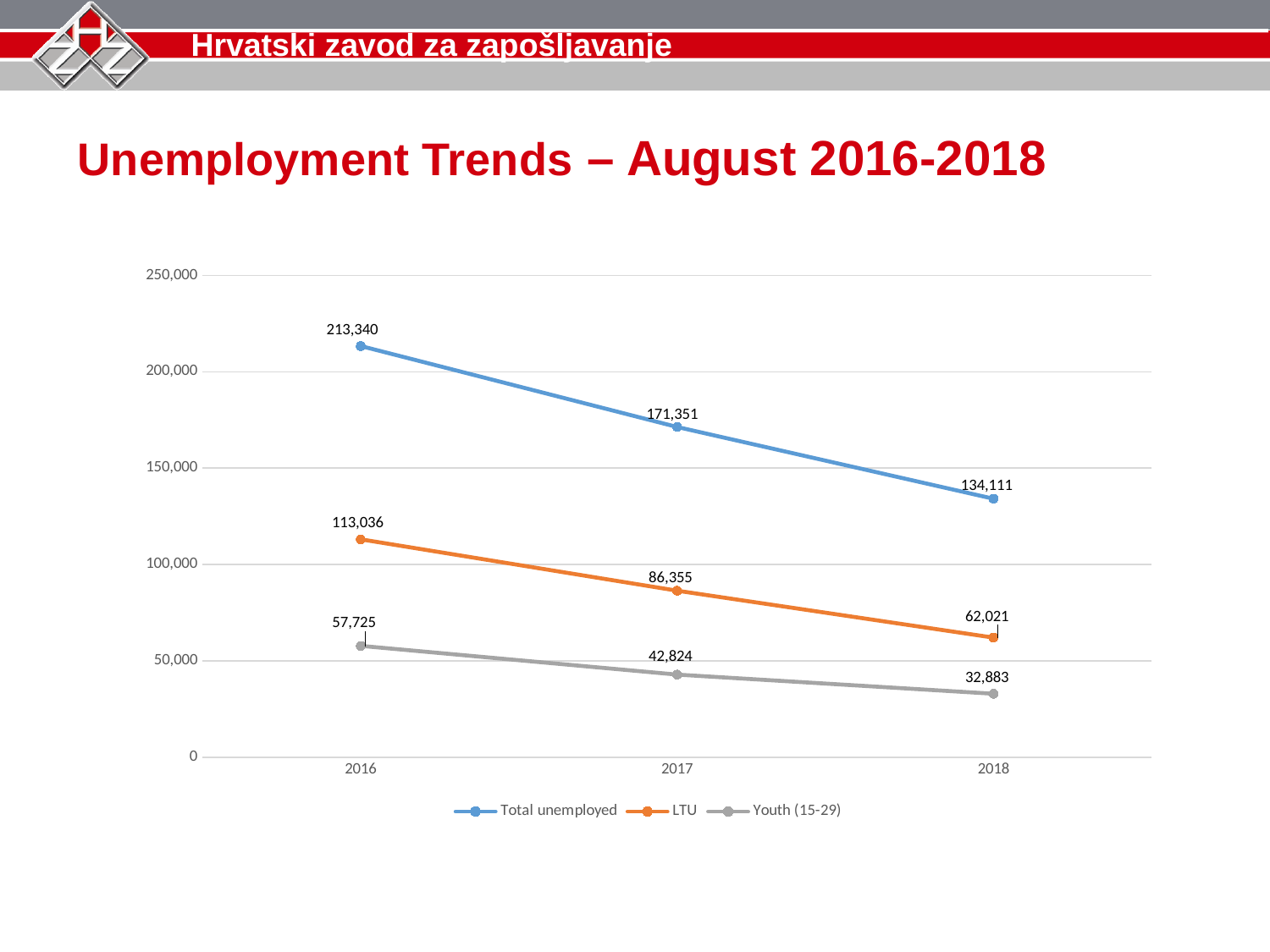
What is the difference between the LTU values in 2016 and 2017? 26,681 What type of chart is shown on the slide? Line chart What is the difference between the Total unemployed values in 2016 and 2018? 79,229 Which is larger: the LTU value in 2018 or the Youth (15-29) value in 2016? LTU in 2018 Is the Youth (15-29) value in 2017 greater or less than 50,000? less What is the value for Total unemployed in 2016? 213,340 How many series does the legend list? 3 In which year is the Total unemployed value lowest? 2018 In which year is the LTU value highest? 2016 What is the value for Youth (15-29) in 2018? 32,883 What is the value for LTU in 2017? 86,355 Do the Total unemployed values rise or fall from 2016 to 2018? fall